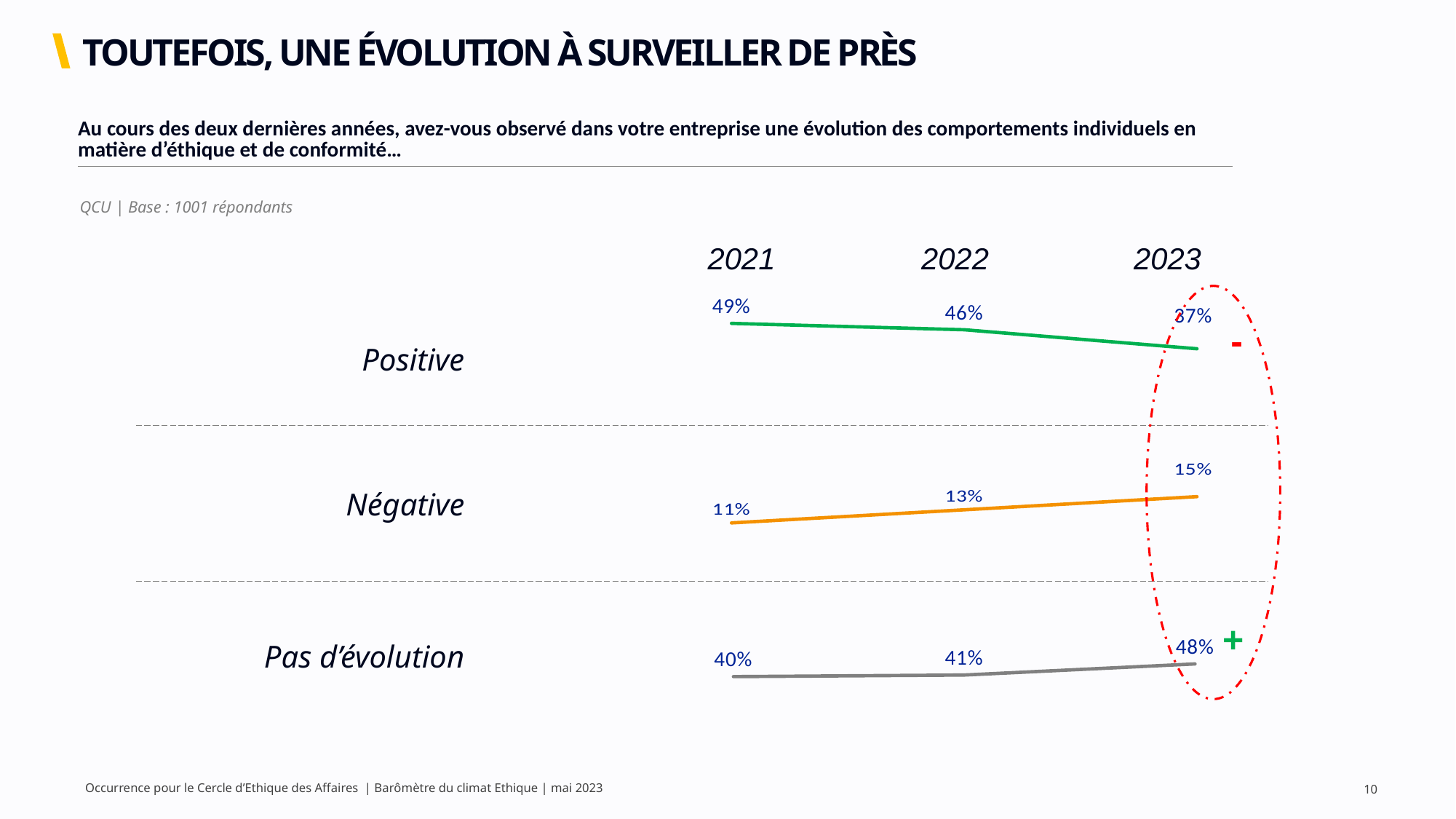
What type of chart is used to show the evolution of each response? line chart What was the value for Positive in 2022? 46% In which year was the Positive line at its highest? 2021 What was the value for Pas d'évolution in 2022? 41% What was the share of respondents observing a Positive evolution in 2021? 49% Does the Positive line rise or fall from 2021 to 2023? fall How many years are shown on the x axis? 3 In which year was the Négative line at its lowest? 2021 By how many percentage points did Pas d'évolution change between 2021 and 2023? 8 percentage points What was the share of respondents observing a Négative evolution in 2023? 15% Which was larger in 2023: Positive or Pas d'évolution? Pas d'évolution Does the Négative line rise or fall from 2021 to 2023? rise